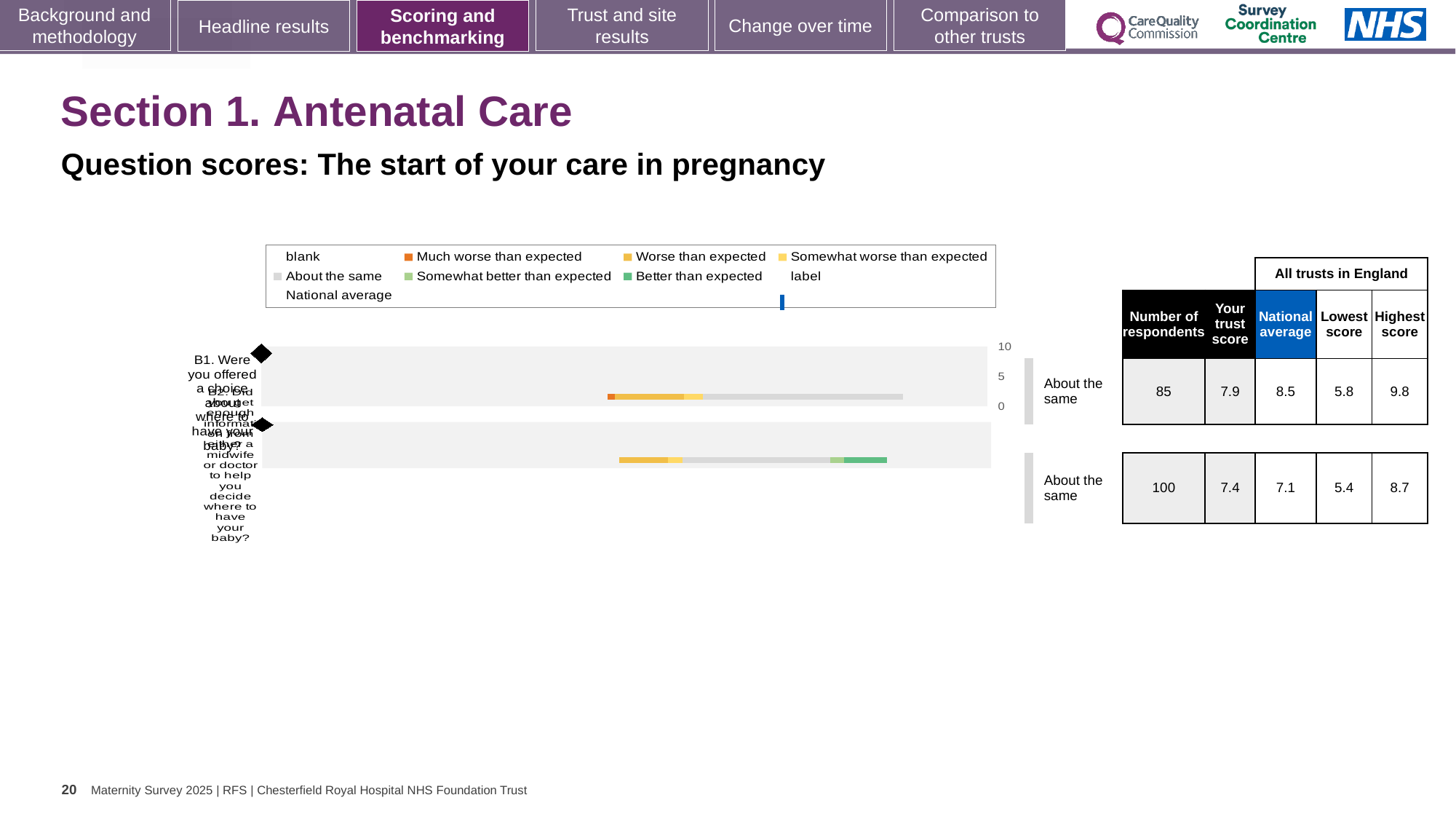
Which question has the higher trust score, B1 or B2? B1 What is the highest score among all trusts in England for question B1? 9.8 What is the trust score for question B1 (Were you offered a choice about where to have your baby?)? 7.9 What kind of chart is used to show the question scores on this slide? bar chart How many respondents answered question B2? 100 What is the trust score for question B2 (Did you get enough information from either a midwife or doctor to help you decide where to have your baby?)? 7.4 What colour does the legend use for 'Better than expected'? green How many questions (categories) are plotted in the chart? 2 What benchmark category is shown next to the bar for question B1? About the same What is the difference between the national average and the trust score for question B1? 0.6 What is the difference between the trust score and the national average for question B2? 0.3 What is the national average score for question B1? 8.5